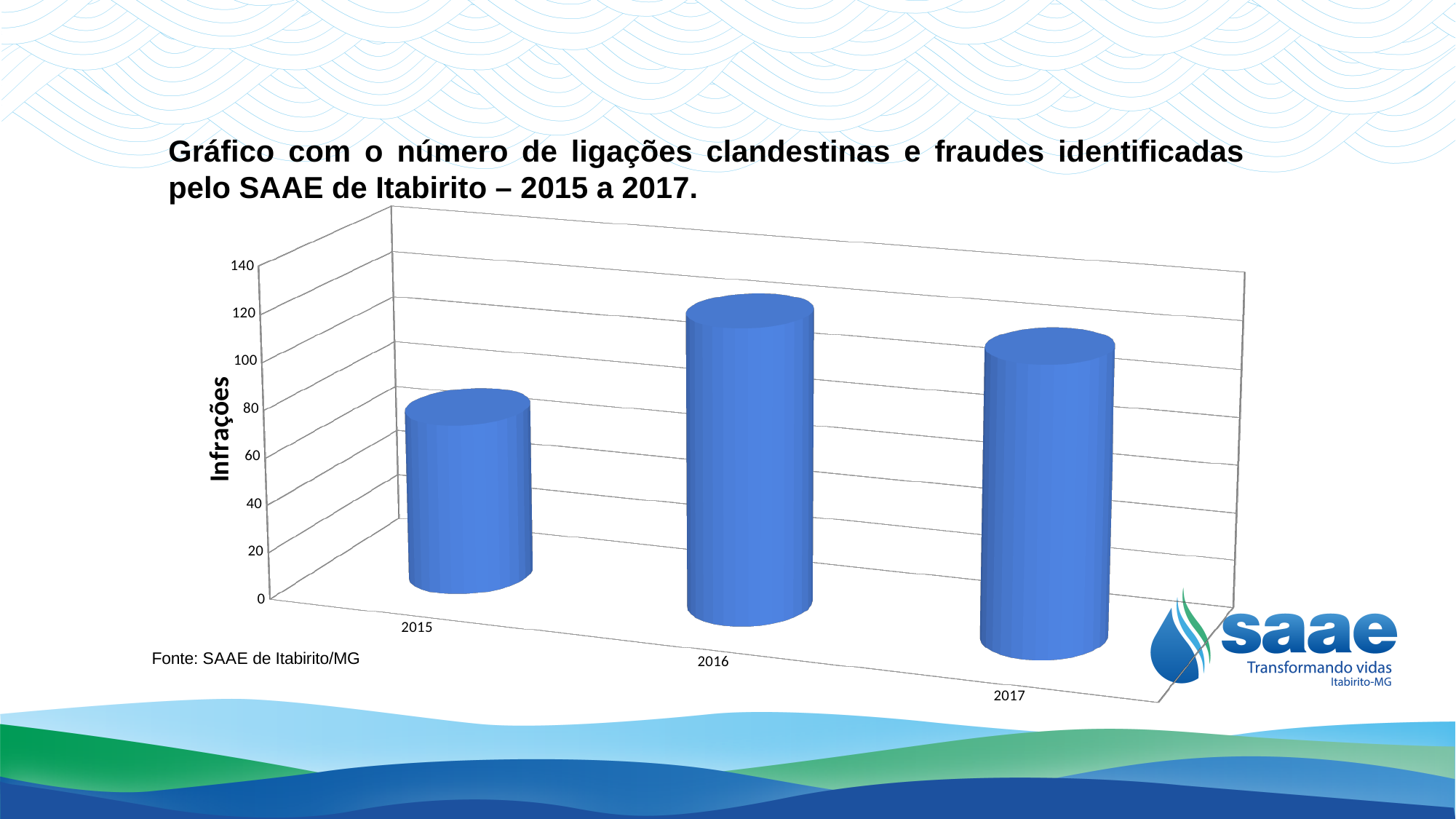
What is the label on the vertical axis of the chart? Infrações Is the value for 2017 greater or less than 80? greater What is the highest value shown on the vertical axis of the chart? 140 Which is larger, the value for 2015 or the value for 2016? 2016 What kind of chart is shown on the slide? bar chart Which year has the lowest number of infrações? 2015 How many years (categories) are plotted on the chart? 3 Is the value for 2015 greater or less than 100? less Which is larger, the value for 2015 or the value for 2017? 2017 Does the number of infrações rise or fall from 2015 to 2016? rise Is the value for 2015 greater or less than 20? greater